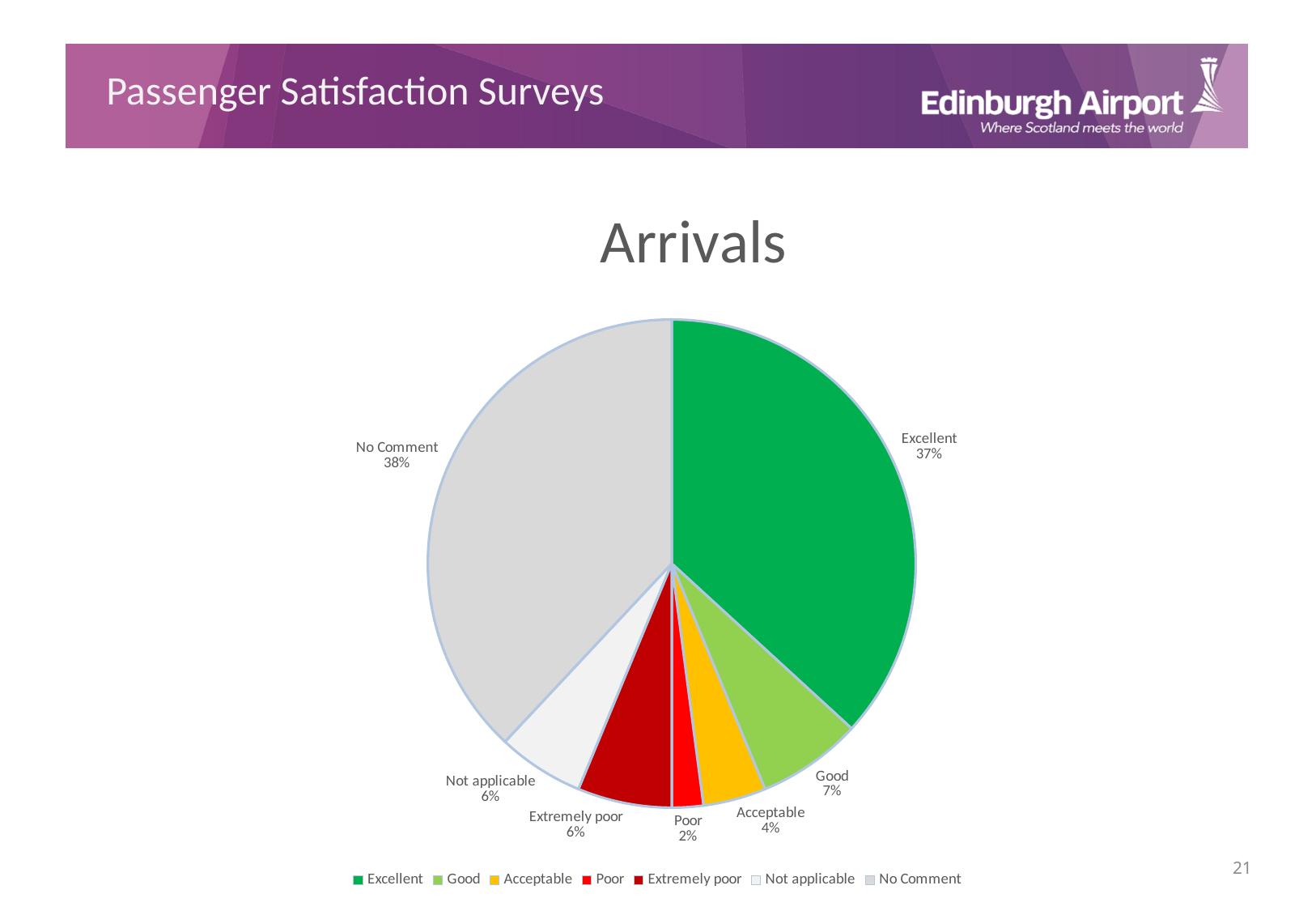
What percentage of the pie is labelled Excellent? 37% Which category has the smallest share of the pie? Poor What type of chart is shown on the slide? pie chart Which is larger, the Acceptable slice or the Extremely poor slice? Extremely poor How many categories does the pie chart have? 7 What percentage of the pie is labelled Good? 7% Which category has the largest share of the pie? No Comment What percentage of the pie is labelled No Comment? 38% What percentage of the pie is labelled Poor? 2% What colour is the Acceptable slice? yellow What is the difference in percentage points between Excellent and Good? 30 What is the title of the chart? Arrivals